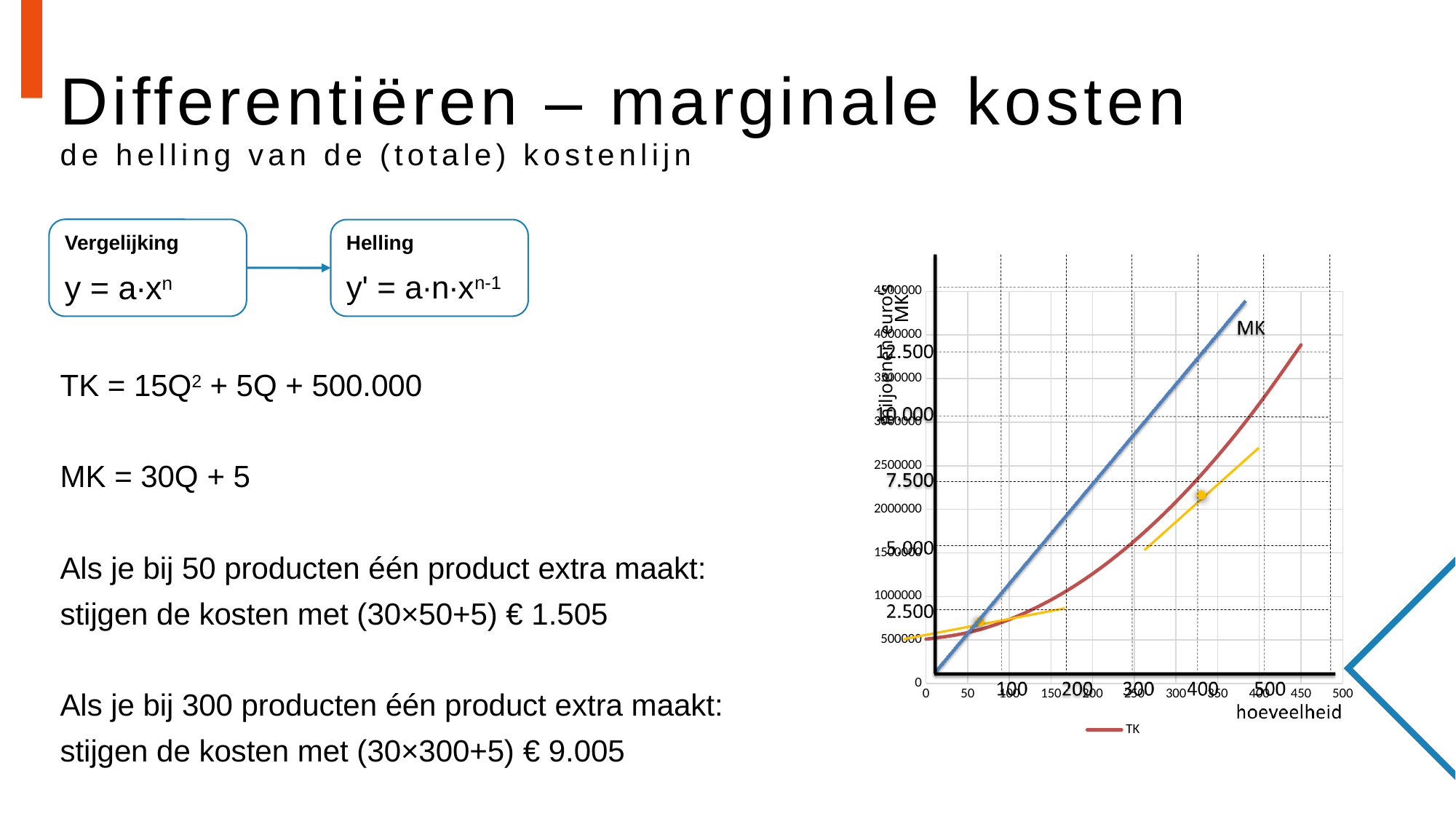
What kind of chart is shown on the slide? line chart Which series is listed in the chart's legend? TK How many series does the chart's legend list? 1 What is the title of the x axis of the chart? hoeveelheid Does the TK line rise or fall as hoeveelheid increases? rises Is the value of TK at hoeveelheid 100 greater or less than 1000000? less Is the value of TK at hoeveelheid 400 greater or less than 2500000? greater